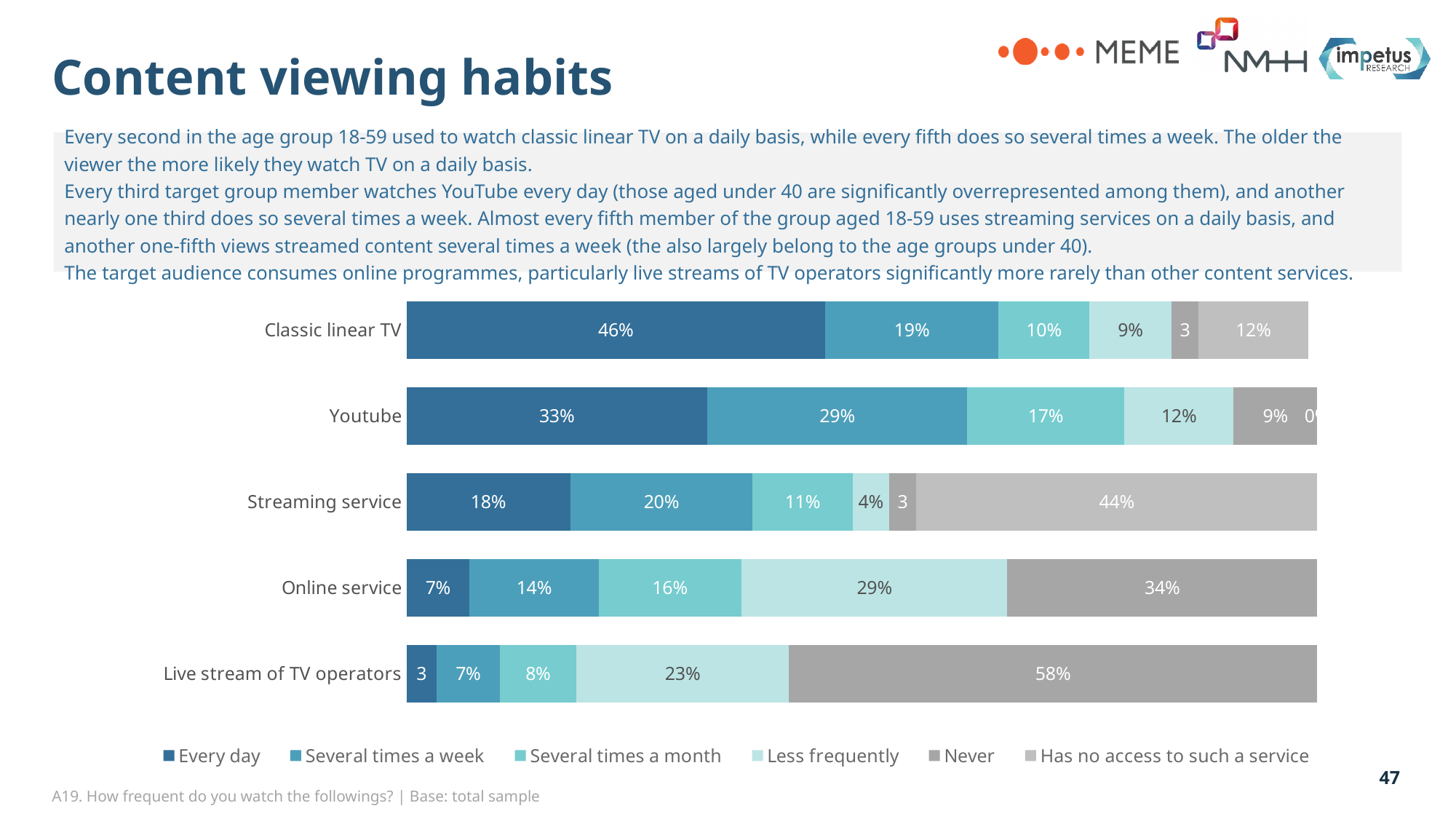
How many content types are shown in the chart? 5 Which content type has the highest share of 'Every day' viewers? Classic linear TV What percentage of respondents use an online service less frequently? 29% What is the difference between the 'Every day' share for classic linear TV and for YouTube? 13 percentage points Which content type has the lowest share of 'Every day' viewers? Live stream of TV operators Which is larger: the 'Several times a week' share for streaming service or for online service? Streaming service What percentage of respondents watch YouTube several times a week? 29% What kind of chart is shown on the slide? Stacked bar chart What percentage of respondents watch classic linear TV every day? 46% What share of respondents has no access to a streaming service? 44% How many series does the legend list? 6 What percentage of respondents never watch live streams of TV operators? 58%